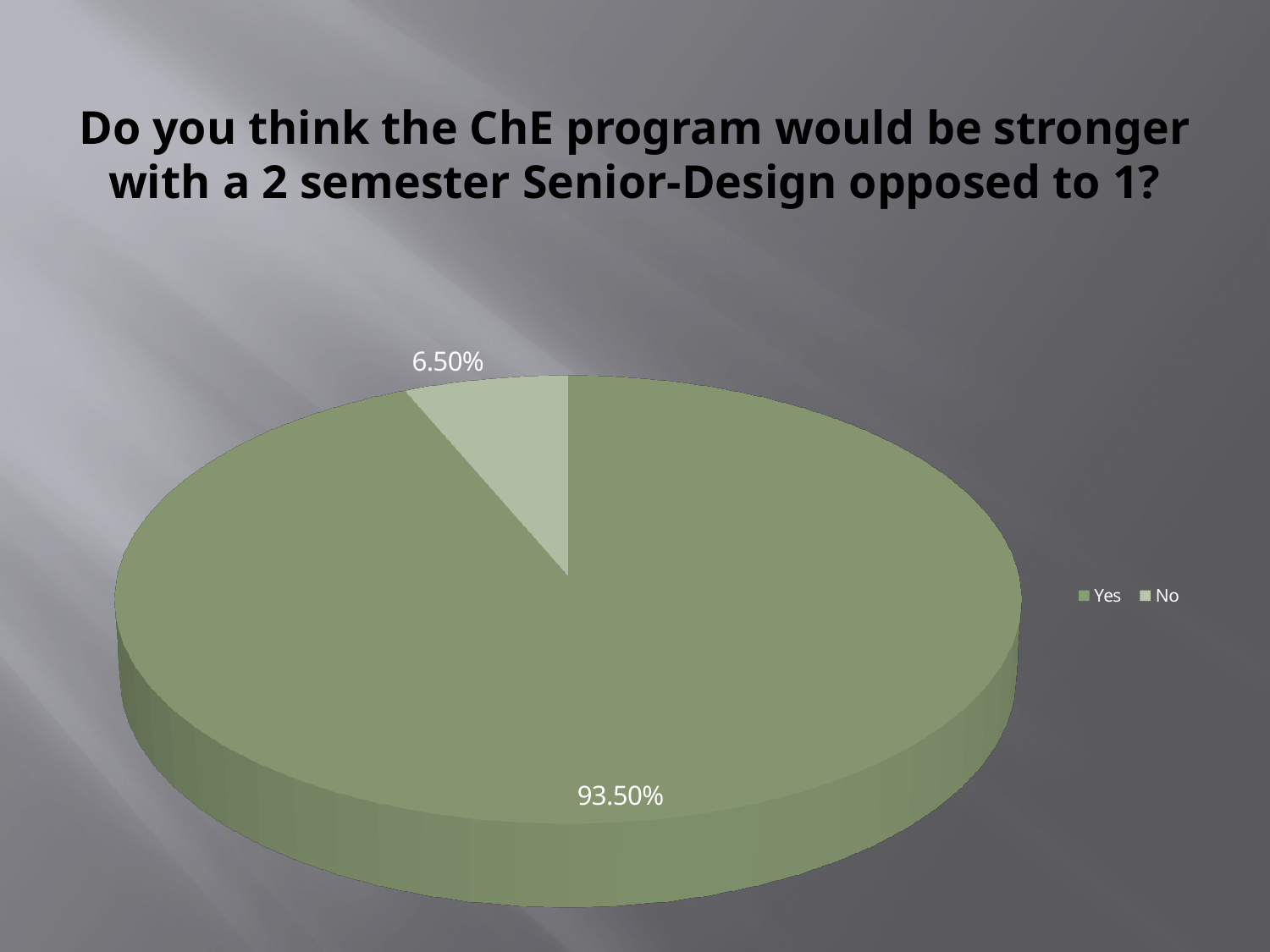
What is the difference in percentage points between the Yes and No shares? 87.00 percentage points What kind of chart is shown on the slide? pie chart What share of the pie does the No slice represent? 6.50% What percentage of respondents answered Yes? 93.50% How many entries does the legend list? 2 Which legend entry is shown in the lighter green colour? No Which is larger, the Yes share or the No share? Yes Which response has the smallest share of the pie? No Which response has the largest share of the pie? Yes What percentage of respondents answered No? 6.50% How many slices does the pie chart have? 2 What is the title of the chart? Do you think the ChE program would be stronger with a 2 semester Senior-Design opposed to 1?